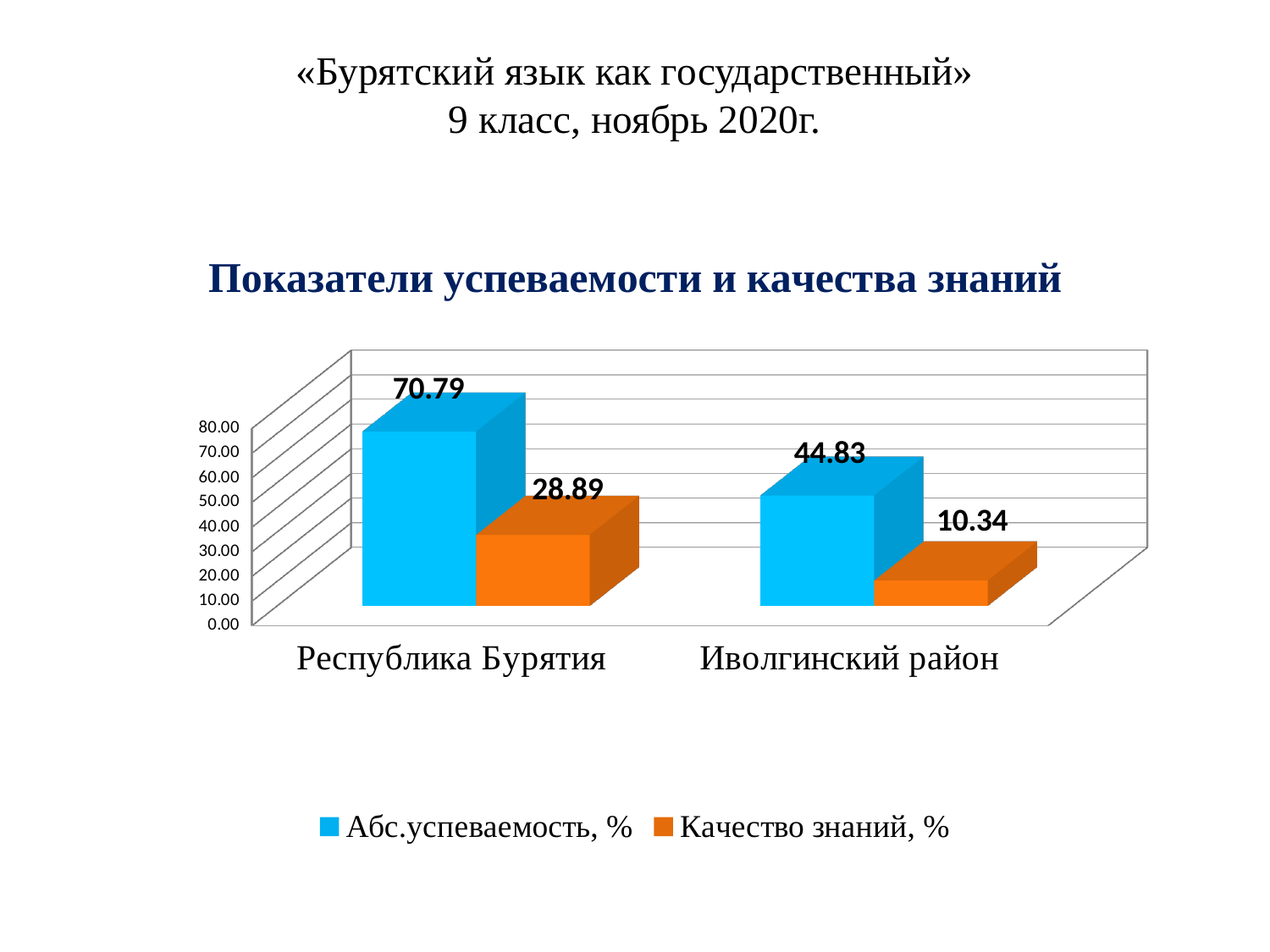
What is the value of Абс.успеваемость, % for Иволгинский район? 44.83 What is the difference between Качество знаний, % for Республика Бурятия and for Иволгинский район? 18.55 Which category has the highest value for Абс.успеваемость, %? Республика Бурятия Which category has the lowest value for Качество знаний, %? Иволгинский район How many categories are shown on the x axis? 2 Which is larger: Абс.успеваемость, % for Иволгинский район or Качество знаний, % for Республика Бурятия? Абс.успеваемость, % for Иволгинский район How many series does the legend list? 2 What is the difference between Абс.успеваемость, % for Республика Бурятия and for Иволгинский район? 25.96 What is the value of Качество знаний, % for Иволгинский район? 10.34 What is the value of Абс.успеваемость, % for Республика Бурятия? 70.79 What kind of chart is shown on the slide? Bar chart What is the value of Качество знаний, % for Республика Бурятия? 28.89